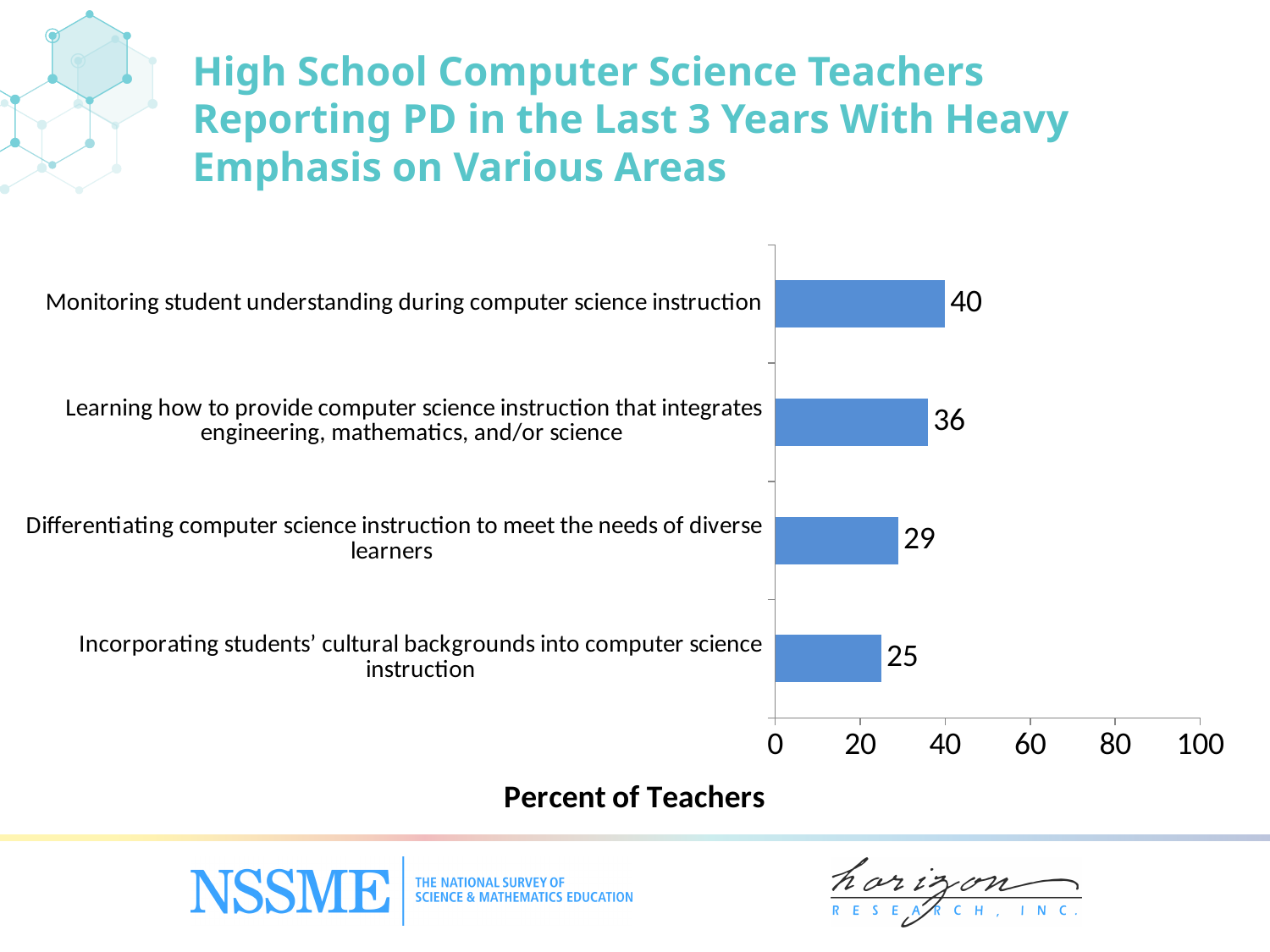
What kind of chart is shown on the slide? Bar chart What is the value for differentiating computer science instruction to meet the needs of diverse learners? 29 Which is larger: the value for learning how to provide computer science instruction that integrates engineering, mathematics, and/or science, or the value for differentiating computer science instruction to meet the needs of diverse learners? Learning how to provide computer science instruction that integrates engineering, mathematics, and/or science Which area has the lowest percent of teachers? Incorporating students' cultural backgrounds into computer science instruction What is the label of the horizontal axis? Percent of Teachers What is the difference between the values for monitoring student understanding and incorporating students' cultural backgrounds? 15 Is the value for differentiating computer science instruction to meet the needs of diverse learners greater or less than 40? less How many areas are shown in the chart? 4 What percent of teachers reported PD with heavy emphasis on incorporating students' cultural backgrounds into computer science instruction? 25 What percent of teachers reported PD with heavy emphasis on monitoring student understanding during computer science instruction? 40 What is the maximum value shown on the horizontal axis? 100 Which area has the highest percent of teachers? Monitoring student understanding during computer science instruction